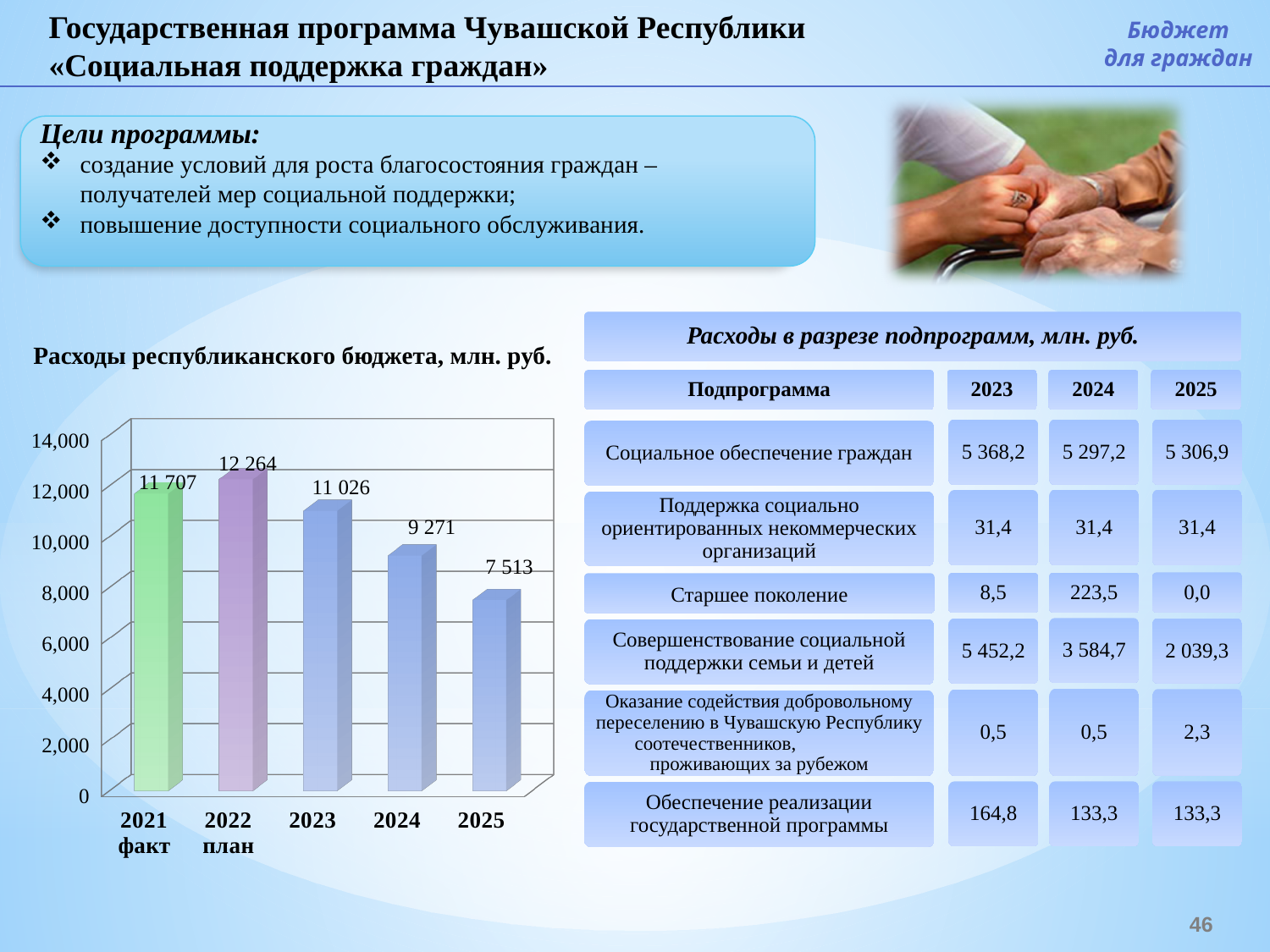
What is the value for 2025 in the chart 'Расходы республиканского бюджета, млн. руб.'? 7 513 Which year has the highest value in the chart 'Расходы республиканского бюджета, млн. руб.'? 2022 план Which year has the lowest value in the chart 'Расходы республиканского бюджета, млн. руб.'? 2025 What is the difference between the 2023 and 2024 values in the chart 'Расходы республиканского бюджета, млн. руб.'? 1 755 How many bars are shown in the chart 'Расходы республиканского бюджета, млн. руб.'? 5 What is the value for 2022 план in the chart 'Расходы республиканского бюджета, млн. руб.'? 12 264 What is the difference between the 2022 план and 2021 факт values in the chart 'Расходы республиканского бюджета, млн. руб.'? 557 In the chart 'Расходы республиканского бюджета, млн. руб.', is the value for 2025 greater or less than 8,000? less What type of chart is 'Расходы республиканского бюджета, млн. руб.'? bar chart What is the value for 2021 факт in the chart 'Расходы республиканского бюджета, млн. руб.'? 11 707 In the chart 'Расходы республиканского бюджета, млн. руб.', which is larger: the value for 2023 or the value for 2024? 2023 In the chart 'Расходы республиканского бюджета, млн. руб.', do the values rise or fall from 2022 план to 2025? fall